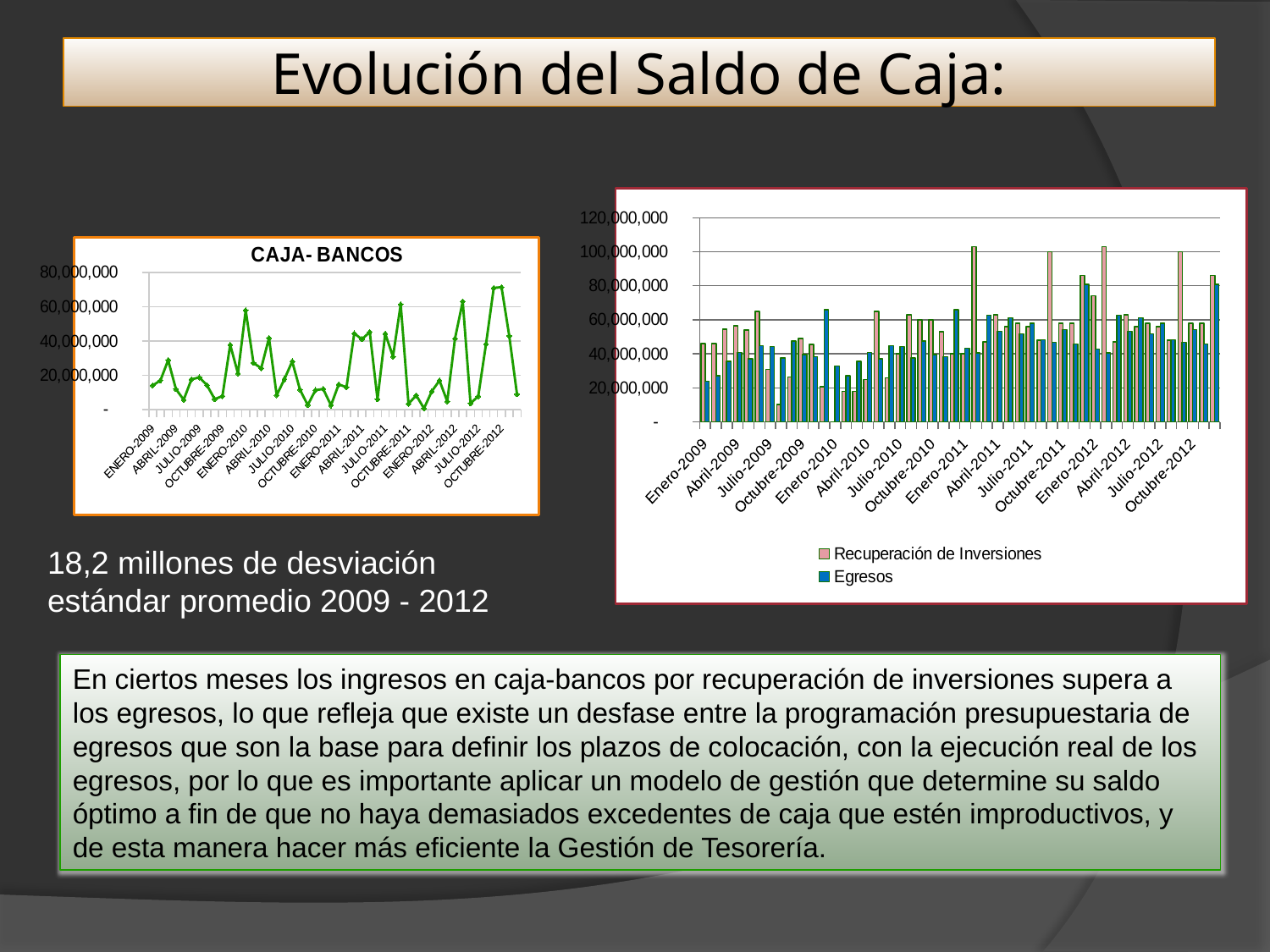
In the left chart CAJA- BANCOS, is the value for ENERO-2009 greater or less than 20,000,000? less What kind of chart is the right chart with the Recuperación de Inversiones and Egresos legend? bar chart In the left chart CAJA- BANCOS, is the value for ENERO-2010 larger or smaller than the value for ENERO-2009? larger In the right chart, is the Recuperación de Inversiones value for Enero-2012 greater or less than 80,000,000? less In the left chart CAJA- BANCOS, is the value for OCTUBRE-2012 greater or less than 60,000,000? greater What kind of chart is the left chart titled CAJA- BANCOS? line chart How many series does the legend of the right chart list? 2 In the right chart, which series is shown in blue according to the legend? Egresos What is the title of the left chart? CAJA- BANCOS What is the highest value shown on the vertical axis of the right chart? 120,000,000